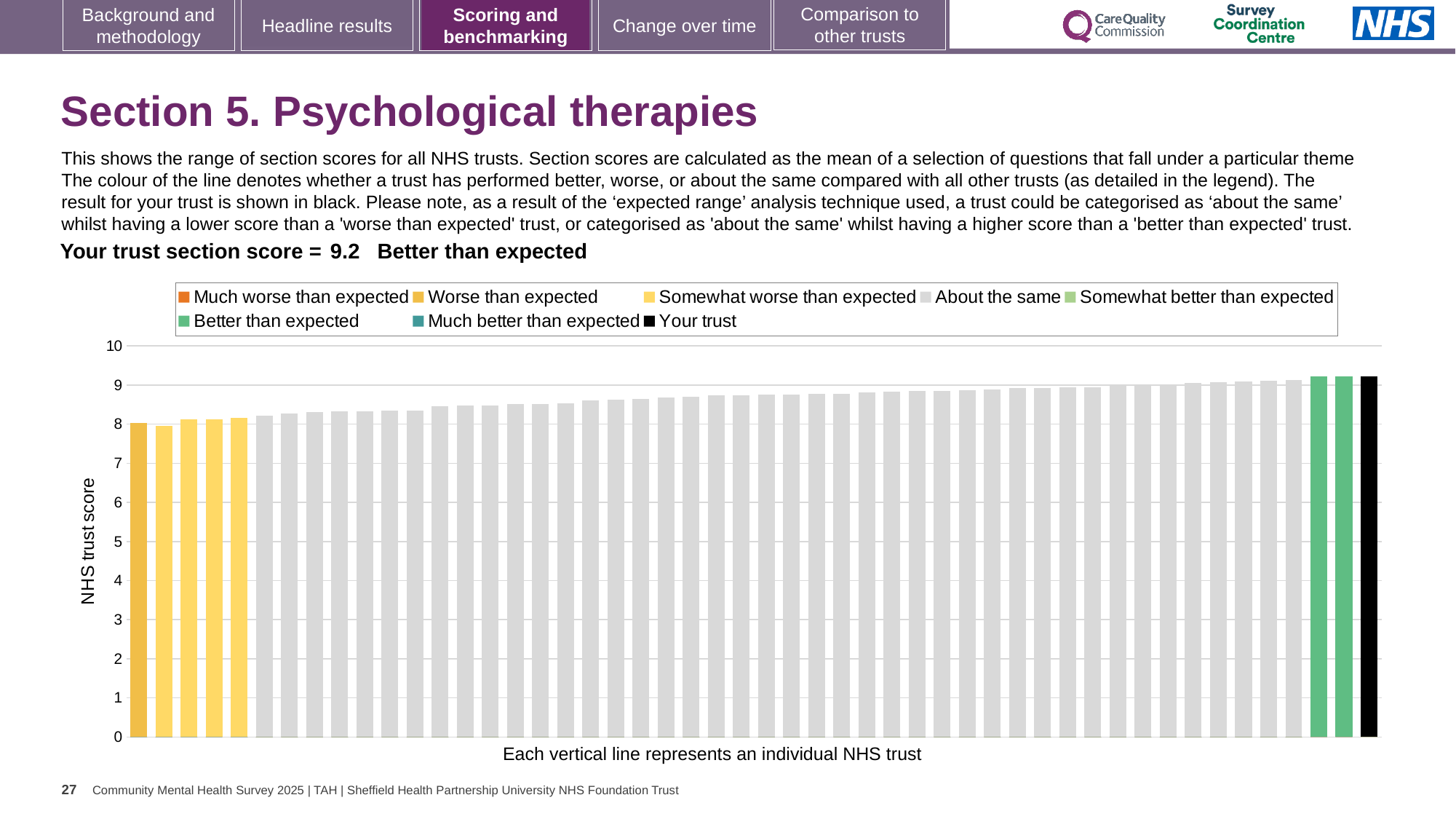
Are any of the bars greater than 10? No Is the value for the leftmost bar greater or less than 9? less According to the slide, how is your trust's section score categorised? Better than expected Is the value for the leftmost bar greater or less than 7? greater What colour is the bar representing your trust? black Do the bar values rise or fall from left to right across the chart? rise How many entries does the chart legend list? 8 What is the section score for your trust shown on the slide? 9.2 What kind of chart is shown on the slide? bar chart How many bars are coloured green (Better than expected)? 2 What is the label on the vertical axis of the chart? NHS trust score